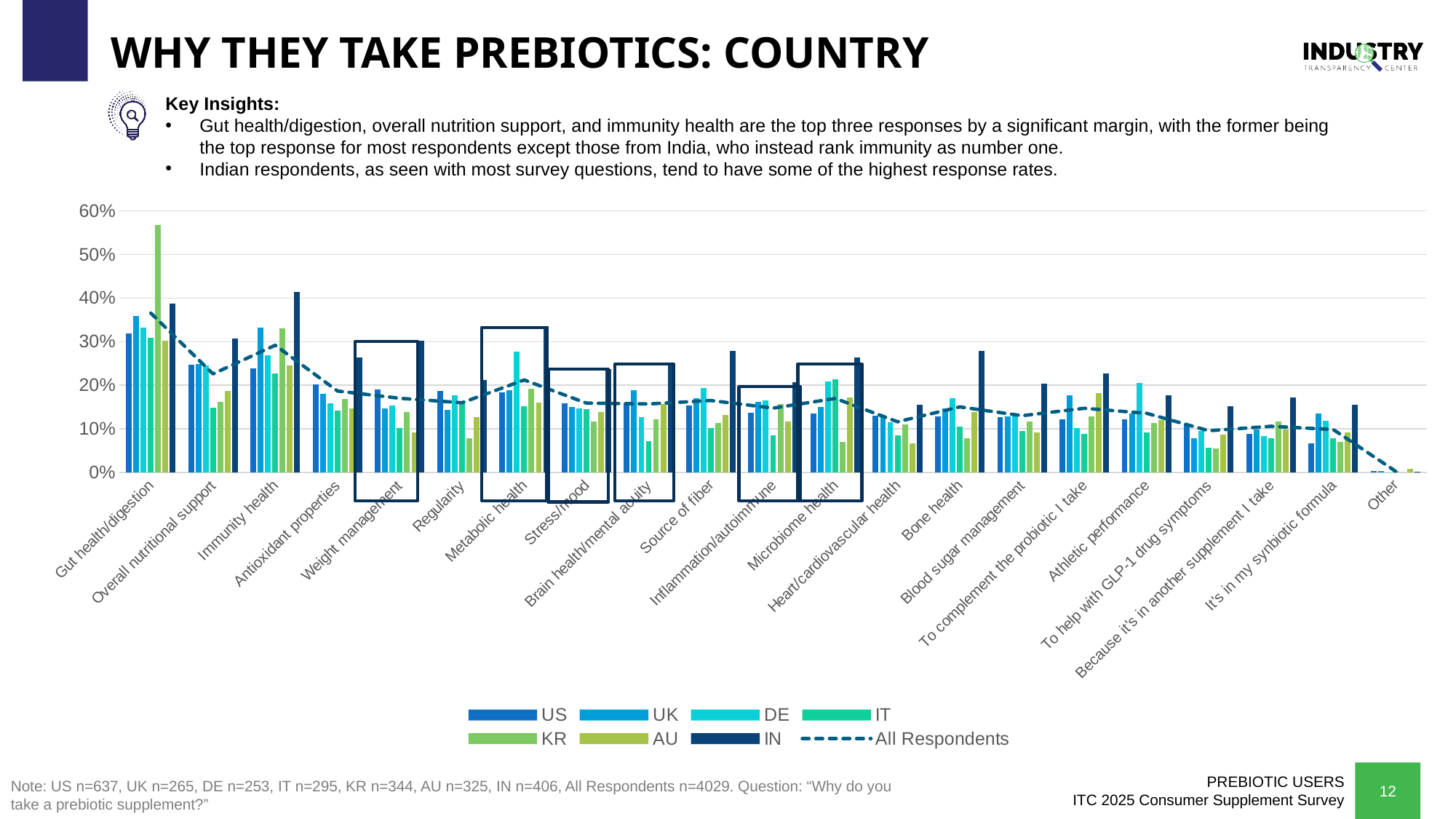
Is the KR value for Gut health/digestion greater or less than 50%? greater Which series is represented by the dashed line in the chart? All Respondents For Immunity health, which is larger: the IN value or the US value? IN How many response categories are shown along the x axis? 21 How many entries does the legend list? 8 Is the DE value for Metabolic health greater or less than 20%? greater What kind of chart is shown on the slide? Bar chart (with a dashed line for All Respondents) Does the All Respondents dashed line generally rise or fall from left to right across the categories? Fall Is the IN value for Bone health greater or less than 20%? greater Which country has the tallest bar for Gut health/digestion? KR